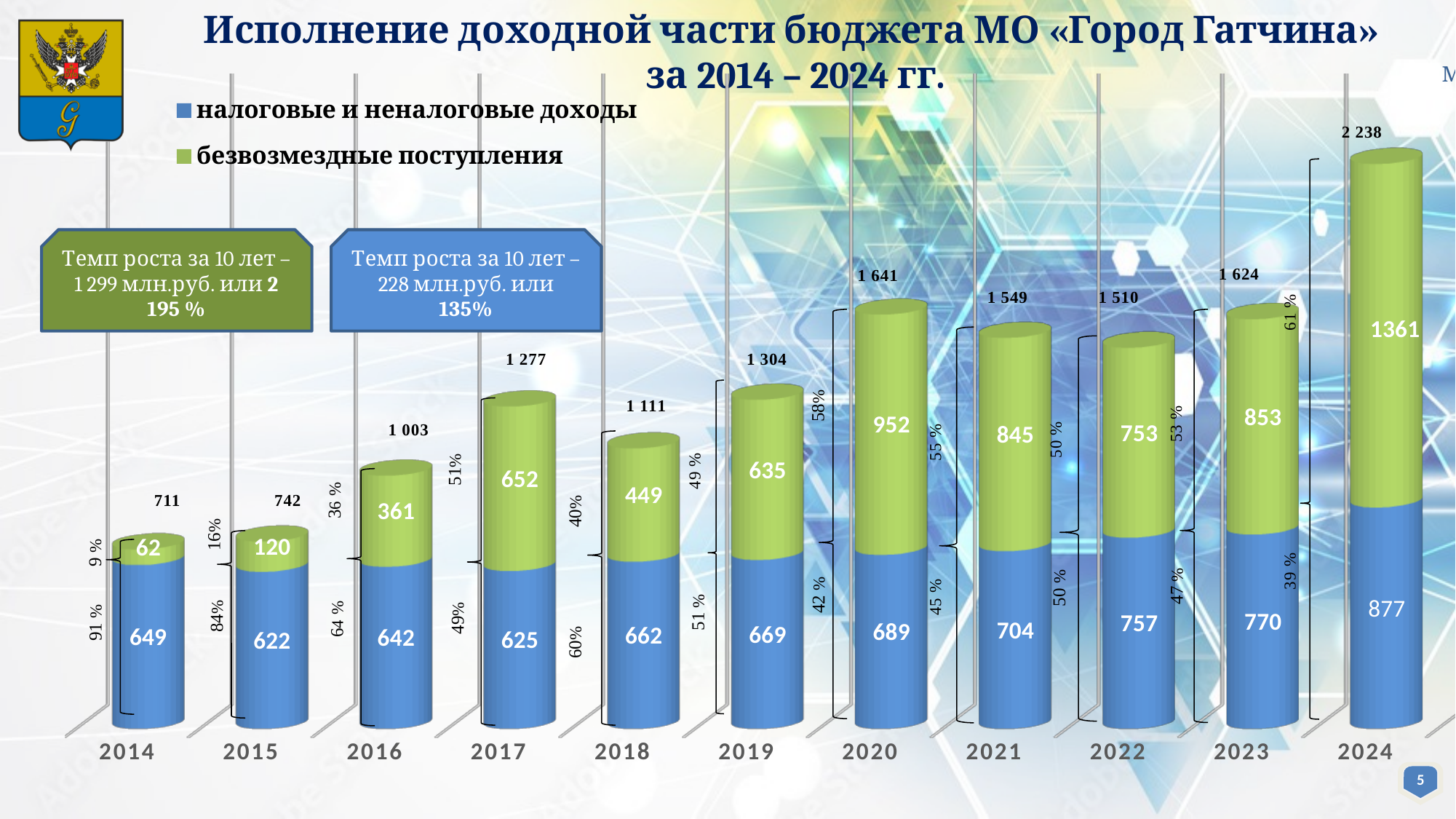
What type of chart is shown on the slide? stacked bar chart Which is larger in 2018: налоговые и неналоговые доходы or безвозмездные поступления? налоговые и неналоговые доходы Do the total revenues generally rise or fall from 2014 to 2024? rise What colour represents безвозмездные поступления in the chart? green Which year has the lowest value of безвозмездные поступления? 2014 How many years are shown on the x axis of the chart? 11 What is the value of налоговые и неналоговые доходы for 2024? 877 Which year has the highest total revenue? 2024 What is the total of the stacked bar for 2017? 1 277 What is the difference between безвозмездные поступления in 2024 and in 2023? 508 What is the value of безвозмездные поступления for 2020? 952 How many series does the legend list? 2